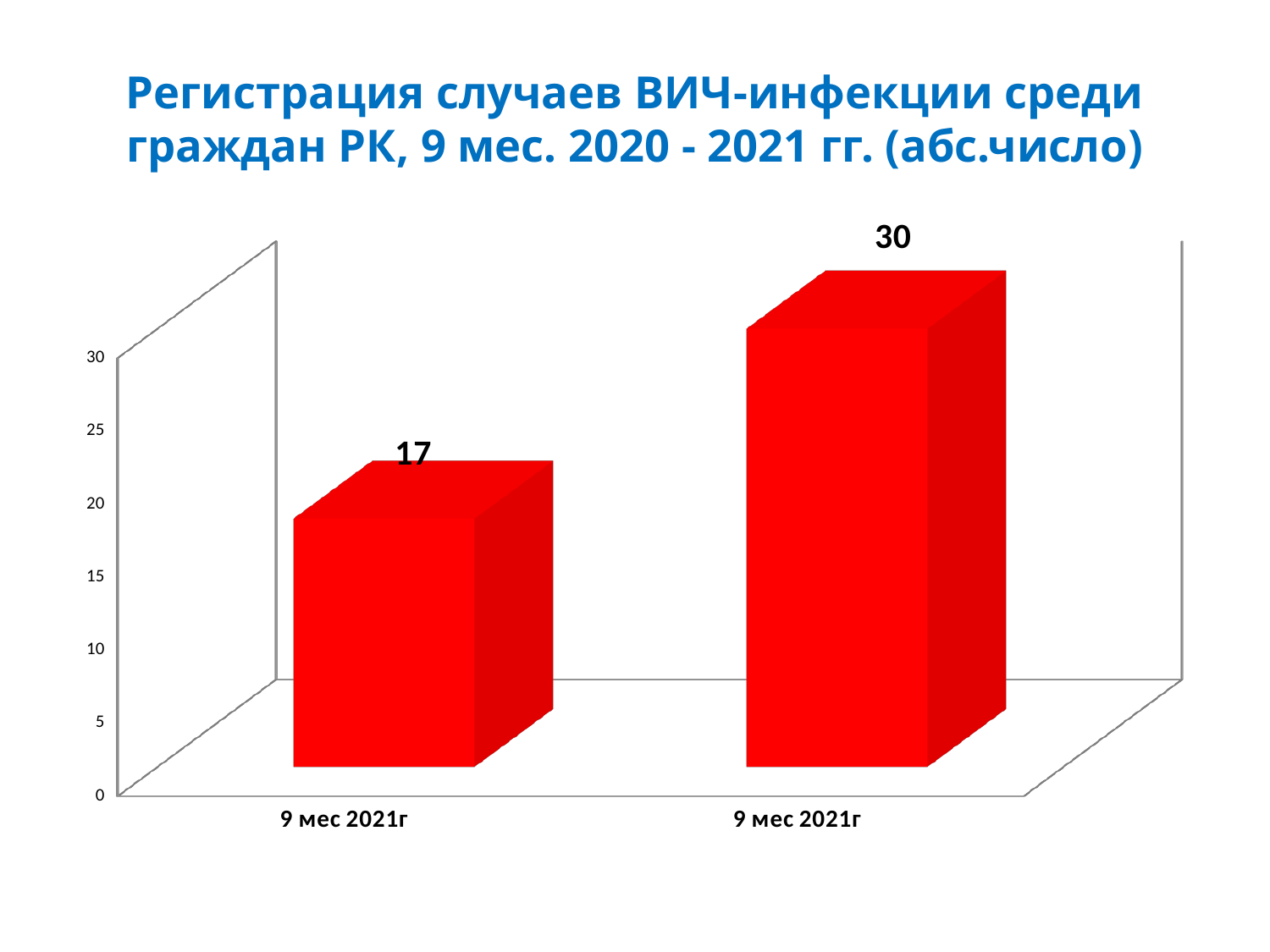
What colour are the bars on the chart? red Is the value of the left bar larger or smaller than the value of the right bar? smaller What is the value shown on the right bar? 30 What is the value shown on the left bar? 17 Is the value of the left bar greater or less than 20? less Which bar is the highest, the left or the right one? the right bar Is the value of the right bar greater or less than 25? greater Do the values rise or fall from the left bar to the right bar? rise How many bars are plotted on the chart? 2 What is the difference between the right bar (30) and the left bar (17)? 13 Which bar is the lowest, the left or the right one? the left bar What kind of chart is shown on the slide? bar chart